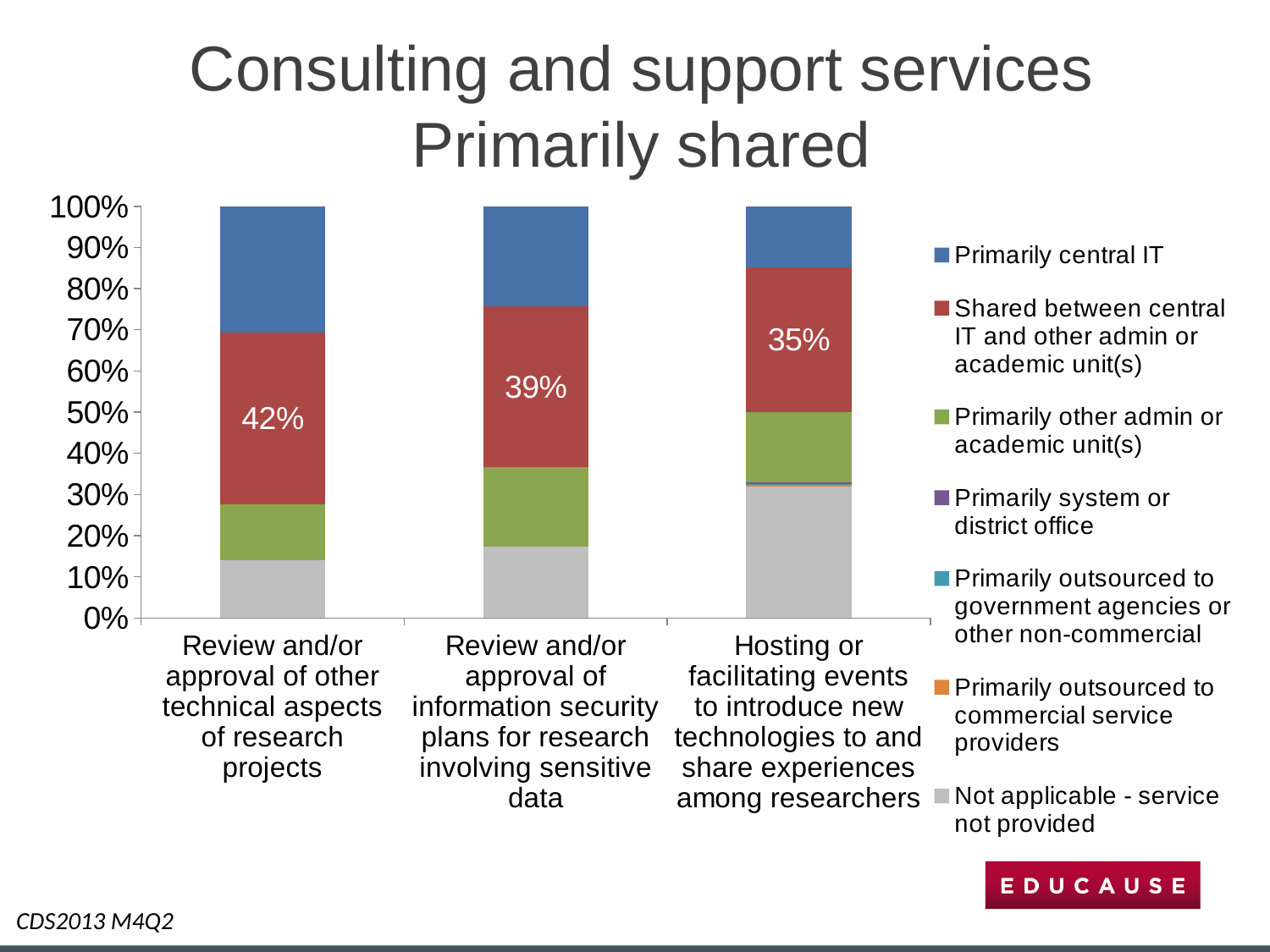
What is the value for 'Shared between central IT and other admin or academic unit(s)' for 'Review and/or approval of information security plans for research involving sensitive data'? 39% What is the value for 'Shared between central IT and other admin or academic unit(s)' for 'Review and/or approval of other technical aspects of research projects'? 42% How many categories are shown on the x axis? 3 What is the difference between the 'Shared' values for 'Review and/or approval of other technical aspects of research projects' and 'Hosting or facilitating events to introduce new technologies to and share experiences among researchers'? 7 percentage points Is the 'Primarily central IT' value for 'Hosting or facilitating events to introduce new technologies to and share experiences among researchers' greater or less than 20%? less What is the value for 'Shared between central IT and other admin or academic unit(s)' for 'Hosting or facilitating events to introduce new technologies to and share experiences among researchers'? 35% Which category has the lowest labelled 'Shared between central IT and other admin or academic unit(s)' value? Hosting or facilitating events to introduce new technologies to and share experiences among researchers How many series does the legend list? 7 Which is larger: the 'Shared' value for 'Review and/or approval of other technical aspects of research projects' or for 'Review and/or approval of information security plans for research involving sensitive data'? Review and/or approval of other technical aspects of research projects What kind of chart is shown on the slide? Stacked bar chart Is the 'Not applicable - service not provided' value for 'Review and/or approval of other technical aspects of research projects' greater or less than 10%? greater Which category has the highest labelled 'Shared between central IT and other admin or academic unit(s)' value? Review and/or approval of other technical aspects of research projects